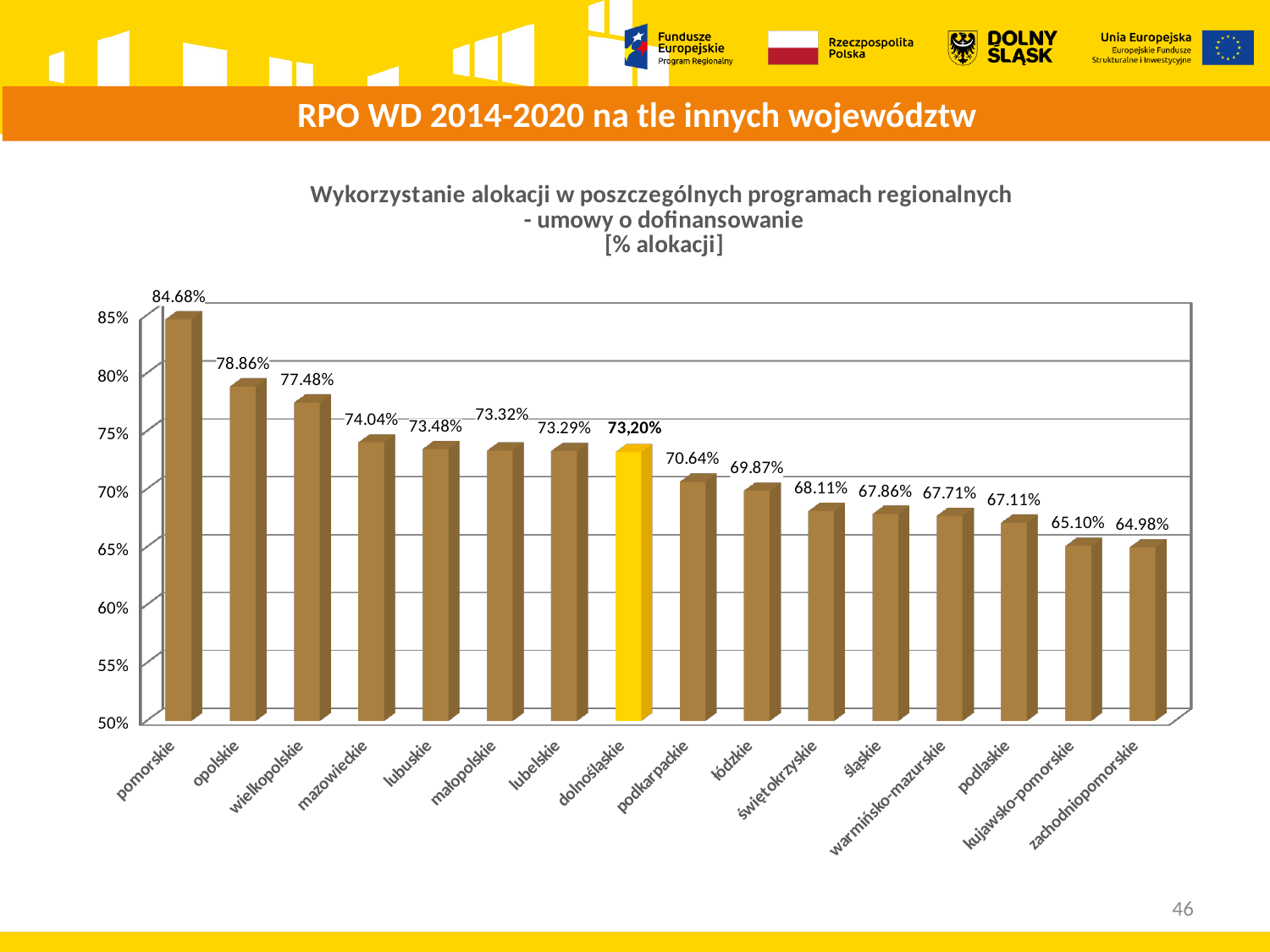
What is the value for dolnośląskie (the highlighted bar)? 73,20% What is the value for podkarpackie? 70.64% Which is larger, the value for wielkopolskie or the value for śląskie? wielkopolskie How many voivodeships are shown on the chart? 16 Do the values rise or fall from left to right along the x axis? fall What is the value for pomorskie? 84.68% What is the difference between the values for pomorskie and opolskie? 5.82 percentage points Which voivodeship has the lowest value? zachodniopomorskie Which voivodeship has the highest value? pomorskie What is the value for warmińsko-mazurskie? 67.71% What kind of chart is shown on the slide? bar chart Is the value for opolskie greater or less than 75%? greater